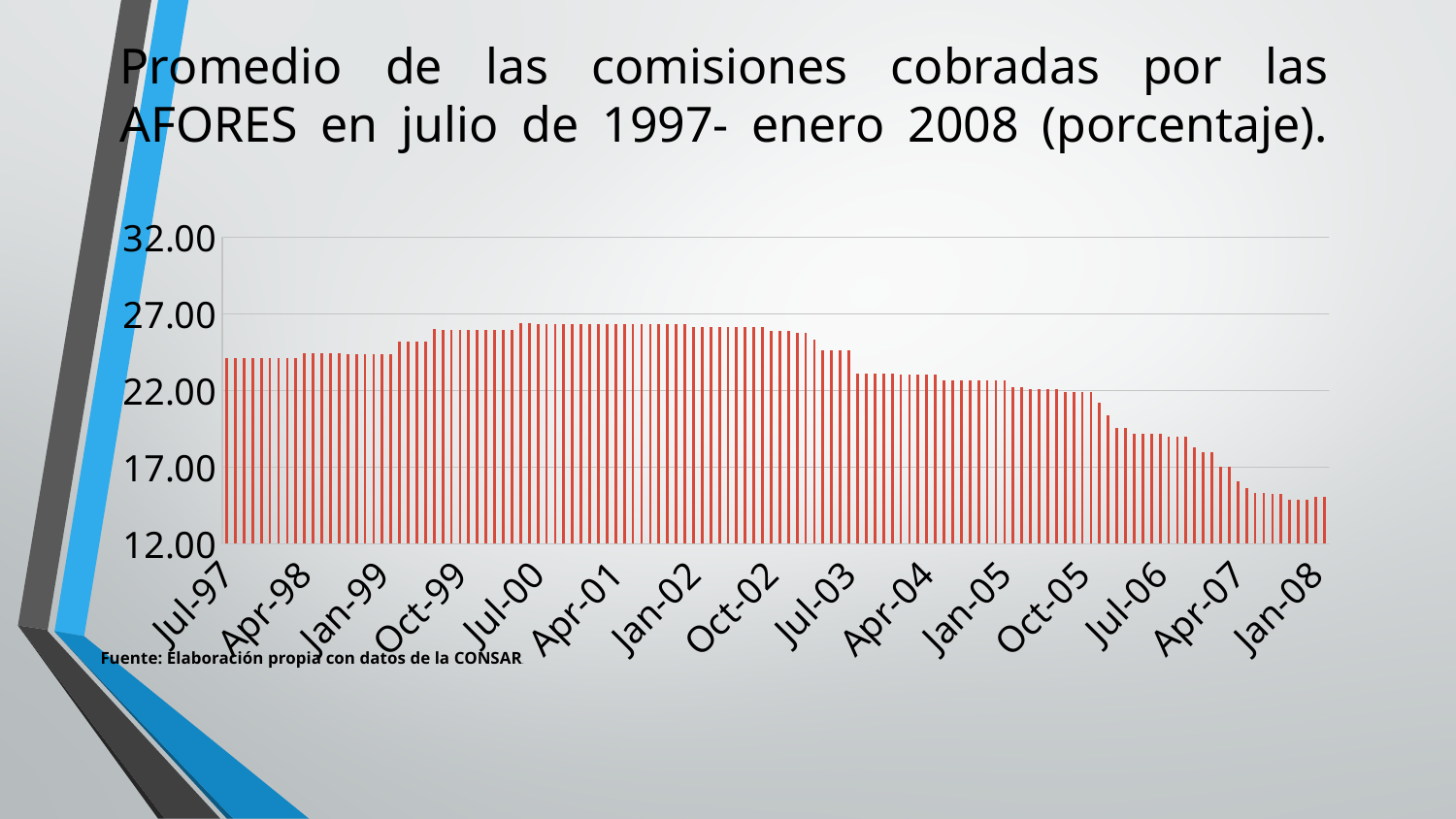
What is the highest value shown on the y axis? 32.00 Is the value for Jul-00 greater or less than 22.00? Greater Which is larger, the value for Jul-97 or the value for Jan-08? Jul-97 Is the value for Jul-06 greater or less than 22.00? Less What kind of chart is shown on the slide? Bar chart Is the value for Jul-03 greater or less than 22.00? Greater Overall, do the values rise or fall from Jul-97 to Jan-08? Fall Which is larger, the value for Jul-00 or the value for Jul-06? Jul-00 How many date labels are shown on the x axis? 15 What source is cited below the chart? Elaboración propia con datos de la CONSAR